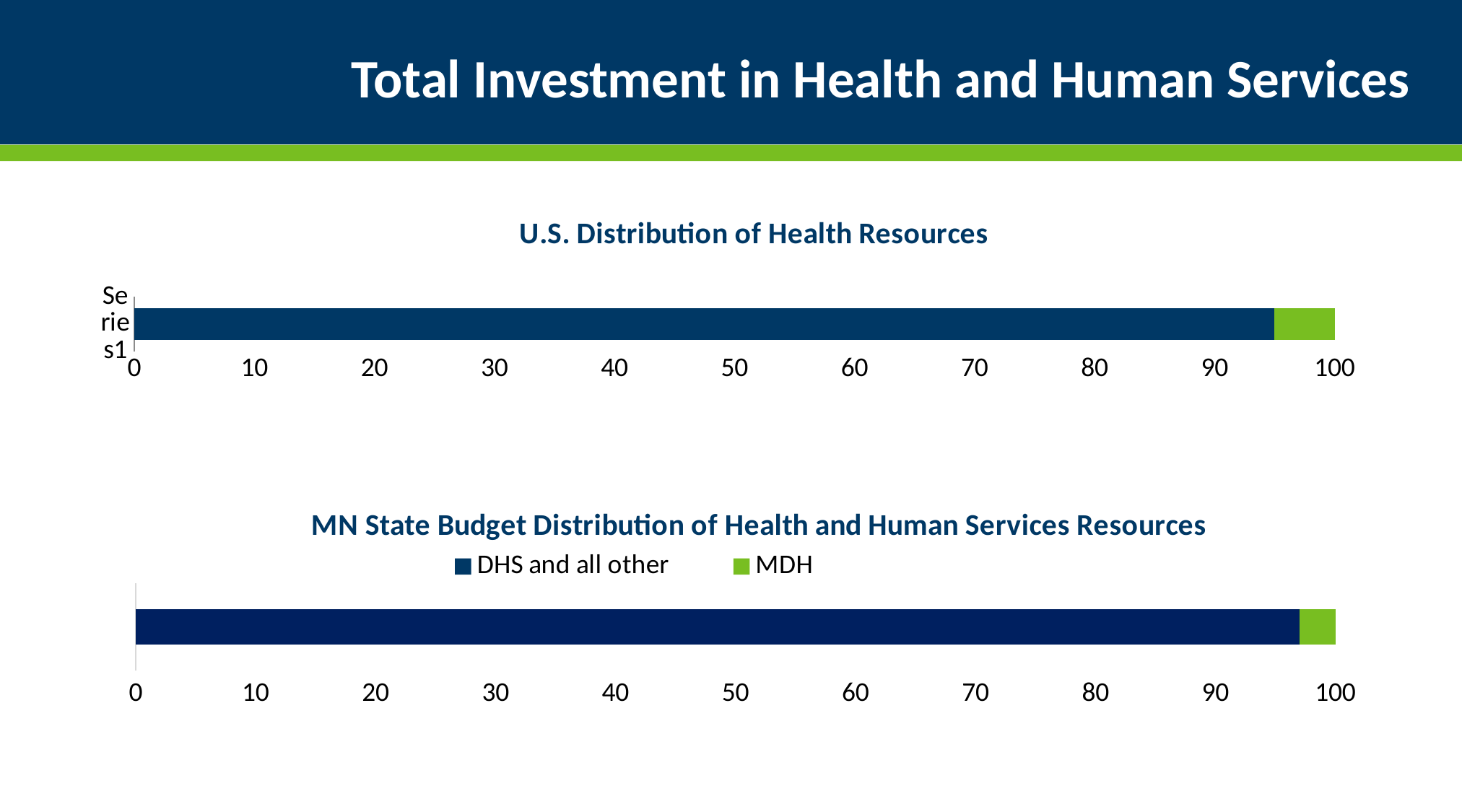
In the 'MN State Budget Distribution of Health and Human Services Resources' chart, which series is shown in green? MDH In the 'U.S. Distribution of Health Resources' chart, is the value of the green segment greater or less than 10? less In the 'MN State Budget Distribution of Health and Human Services Resources' chart, how many series does the legend list? 2 In the 'U.S. Distribution of Health Resources' chart, which segment is larger, the dark blue one or the green one? the dark blue one In the 'MN State Budget Distribution of Health and Human Services Resources' chart, what are the two legend entries? DHS and all other; MDH In the 'MN State Budget Distribution of Health and Human Services Resources' chart, which series has the larger value, 'DHS and all other' or 'MDH'? DHS and all other In the 'MN State Budget Distribution of Health and Human Services Resources' chart, is the value for 'DHS and all other' greater or less than 90? greater In the 'MN State Budget Distribution of Health and Human Services Resources' chart, is the value for 'MDH' greater or less than 10? less What kind of chart is the 'U.S. Distribution of Health Resources' chart? bar chart In the 'U.S. Distribution of Health Resources' chart, how many bars are plotted? 1 What kind of chart is the 'MN State Budget Distribution of Health and Human Services Resources' chart? bar chart